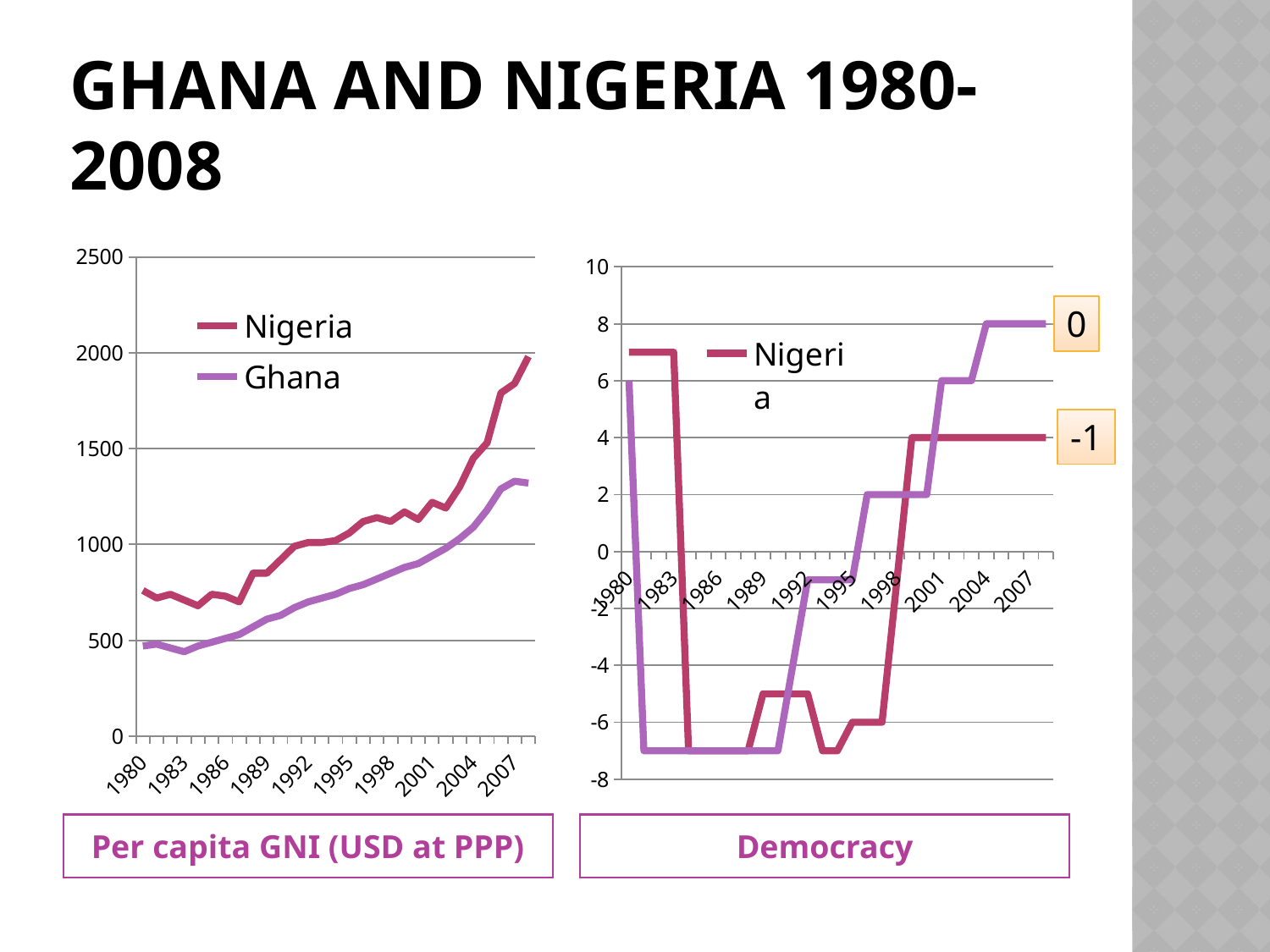
In the 'Per capita GNI (USD at PPP)' chart, which series has the higher value in 2007, Nigeria or Ghana? Nigeria What kind of chart is the 'Per capita GNI (USD at PPP)' chart? Line chart What is the title shown below the right-hand chart? Democracy In the 'Per capita GNI (USD at PPP)' chart, is the value for Nigeria in 2007 greater or less than 1500? greater In the 'Democracy' chart, is the value for Nigeria in 2007 greater or less than 2? greater In the 'Per capita GNI (USD at PPP)' chart, is the value for Ghana in 2007 greater or less than 1500? less In the 'Per capita GNI (USD at PPP)' chart, does the Nigeria line generally rise or fall from 1980 to 2007? Rise In the 'Democracy' chart, which line is higher in 2007, the purple line or the red Nigeria line? The purple line How many series does the legend of the 'Per capita GNI (USD at PPP)' chart list? 2 What kind of chart is the 'Democracy' chart? Line chart